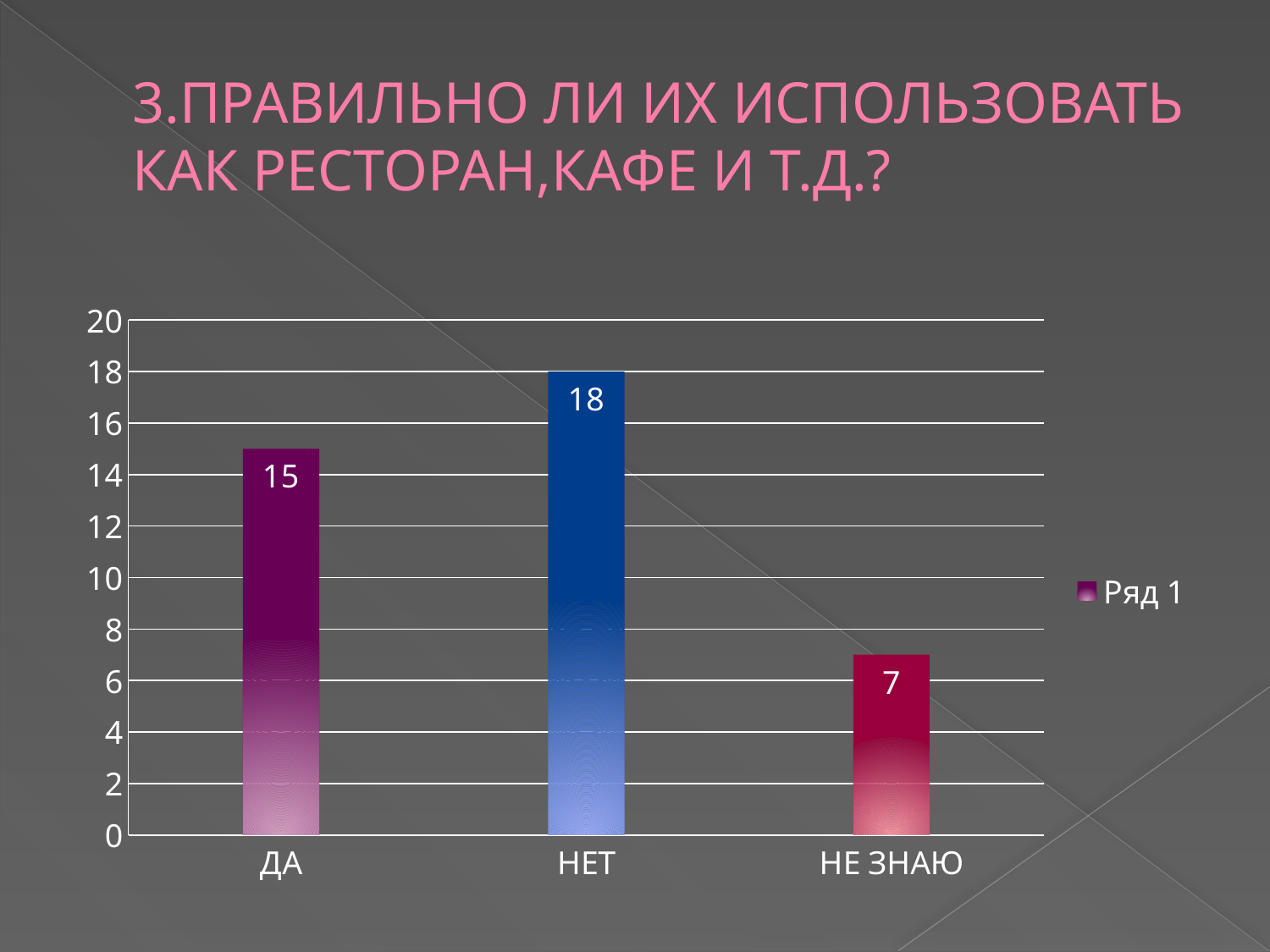
What is the difference between the values for ДА and НЕ ЗНАЮ? 8 Which category has the highest value? НЕТ What is the value for ДА? 15 What kind of chart is shown on the slide? bar chart What is the value for НЕ ЗНАЮ? 7 What is the value for НЕТ? 18 How many categories are shown on the x axis? 3 Is the value for НЕ ЗНАЮ greater or less than 10? less Which is larger, the value for ДА or the value for НЕ ЗНАЮ? ДА Which category has the lowest value? НЕ ЗНАЮ What is the difference between the values for НЕТ and ДА? 3 What series name does the legend list? Ряд 1